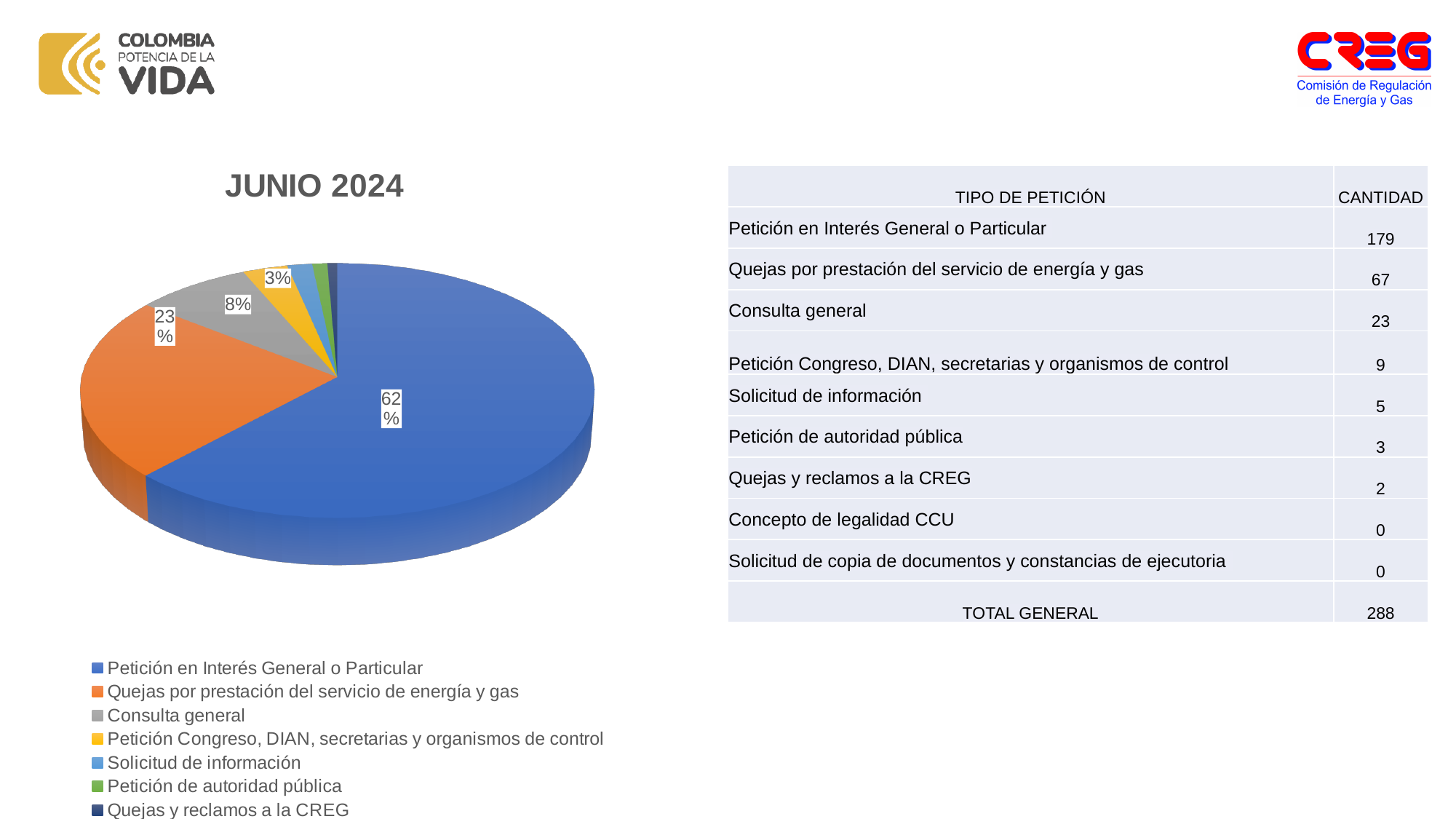
According to the table, what is the CANTIDAD for Consulta general? 23 Which category has the largest slice of the pie? Petición en Interés General o Particular What colour is the slice for Petición en Interés General o Particular? Blue What is the difference in percentage points between the Petición en Interés General o Particular slice and the Quejas por prestación del servicio de energía y gas slice? 39 percentage points What share of the pie does Quejas por prestación del servicio de energía y gas represent? 23% Which slice is larger, Consulta general or Quejas por prestación del servicio de energía y gas? Quejas por prestación del servicio de energía y gas What share of the pie does Consulta general represent? 8% What share of the pie does Petición en Interés General o Particular represent? 62% How many categories does the pie chart legend list? 7 What type of chart is shown on the slide? Pie chart What is the title of the pie chart? JUNIO 2024